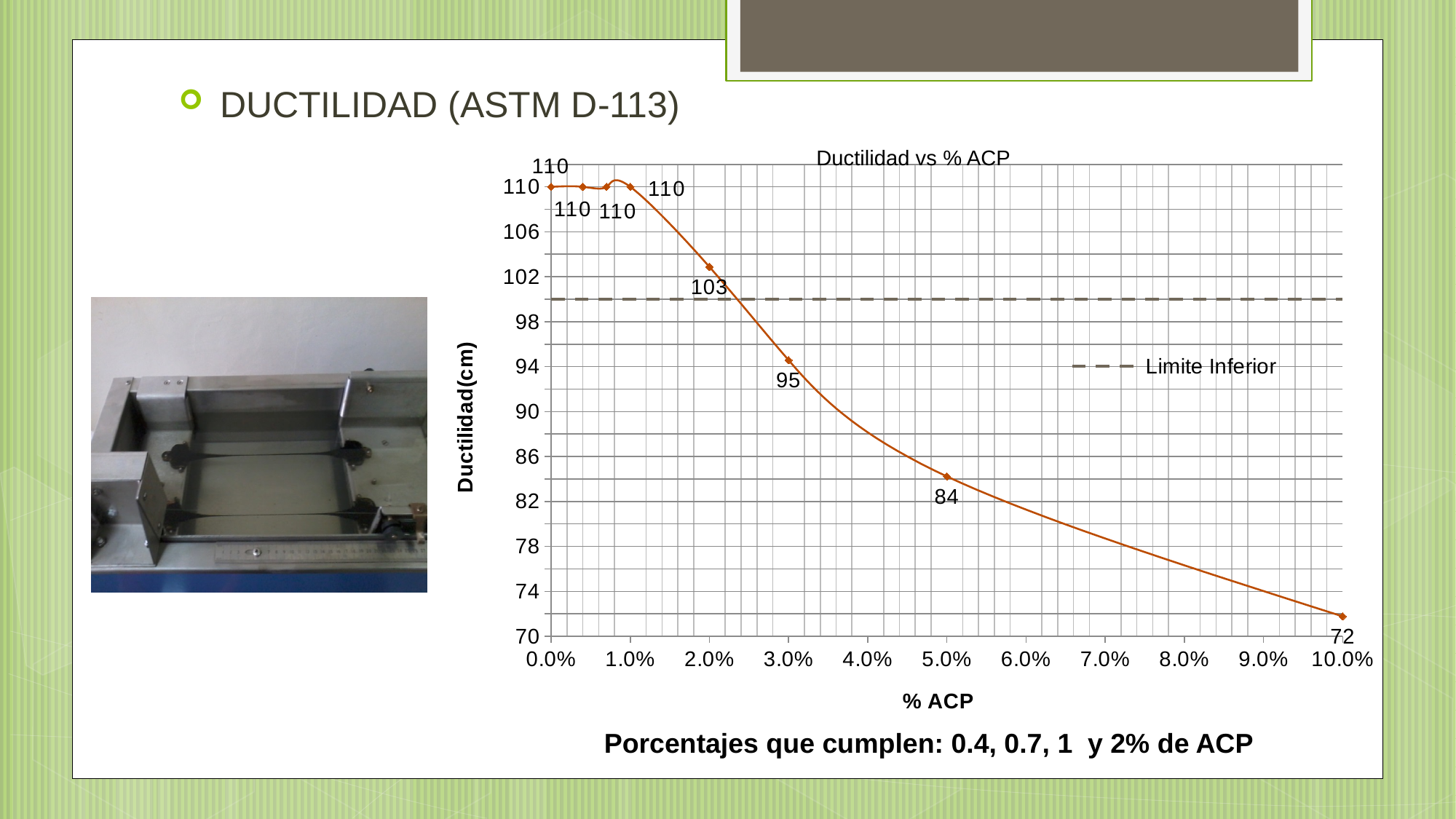
At which % ACP is the ductility lowest? 10.0% What is the ductility value at 0.0% ACP? 110 What type of chart is shown on the slide? line chart What is the difference between the ductility at 2.0% ACP and at 5.0% ACP? 19 What is the ductility value at 5.0% ACP? 84 What is the ductility value at 3.0% ACP? 95 How many data points are plotted on the ductility line? 8 What is the ductility value at 10.0% ACP? 72 Does the ductility rise or fall as % ACP increases from 1.0% to 10.0%? fall What is the ductility value at 2.0% ACP? 103 Which is larger, the ductility at 3.0% ACP or at 5.0% ACP? 3.0% ACP What is the title of the chart? Ductilidad vs % ACP